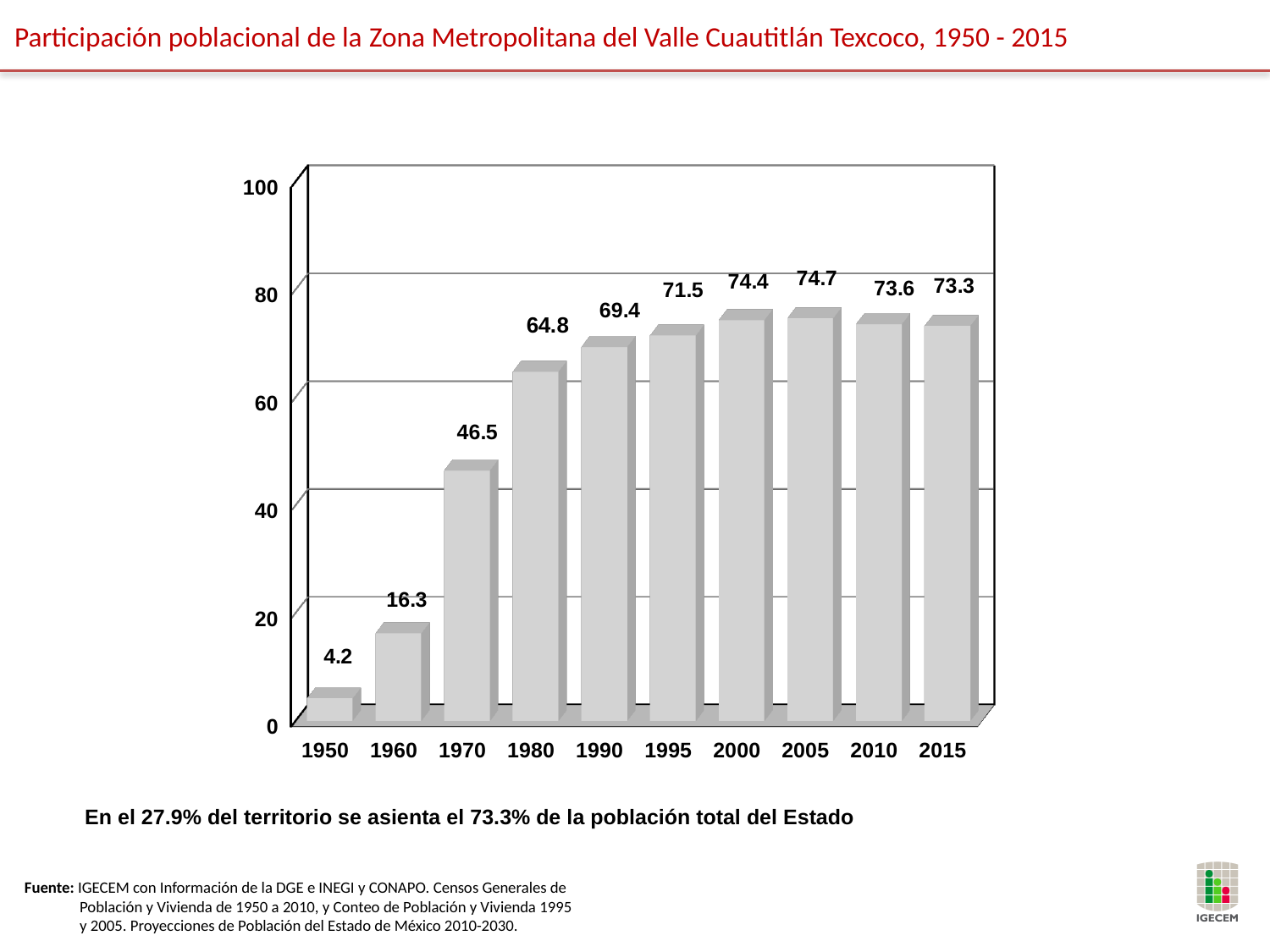
What is the value for 2015? 73.3 What is the value for 1950? 4.2 Is the value for 1970 greater or less than 40? greater Do the values rise or fall from 1950 to 1980? rise What kind of chart is shown on the slide? bar chart Which year has the lowest value? 1950 What is the difference between the values for 1970 and 1960? 30.2 Which year has the highest value? 2005 Which is larger, the value for 1990 or the value for 1995? 1995 What is the title of the slide? Participación poblacional de la Zona Metropolitana del Valle Cuautitlán Texcoco, 1950 - 2015 How many years are shown on the x axis? 10 What is the value for 1980? 64.8